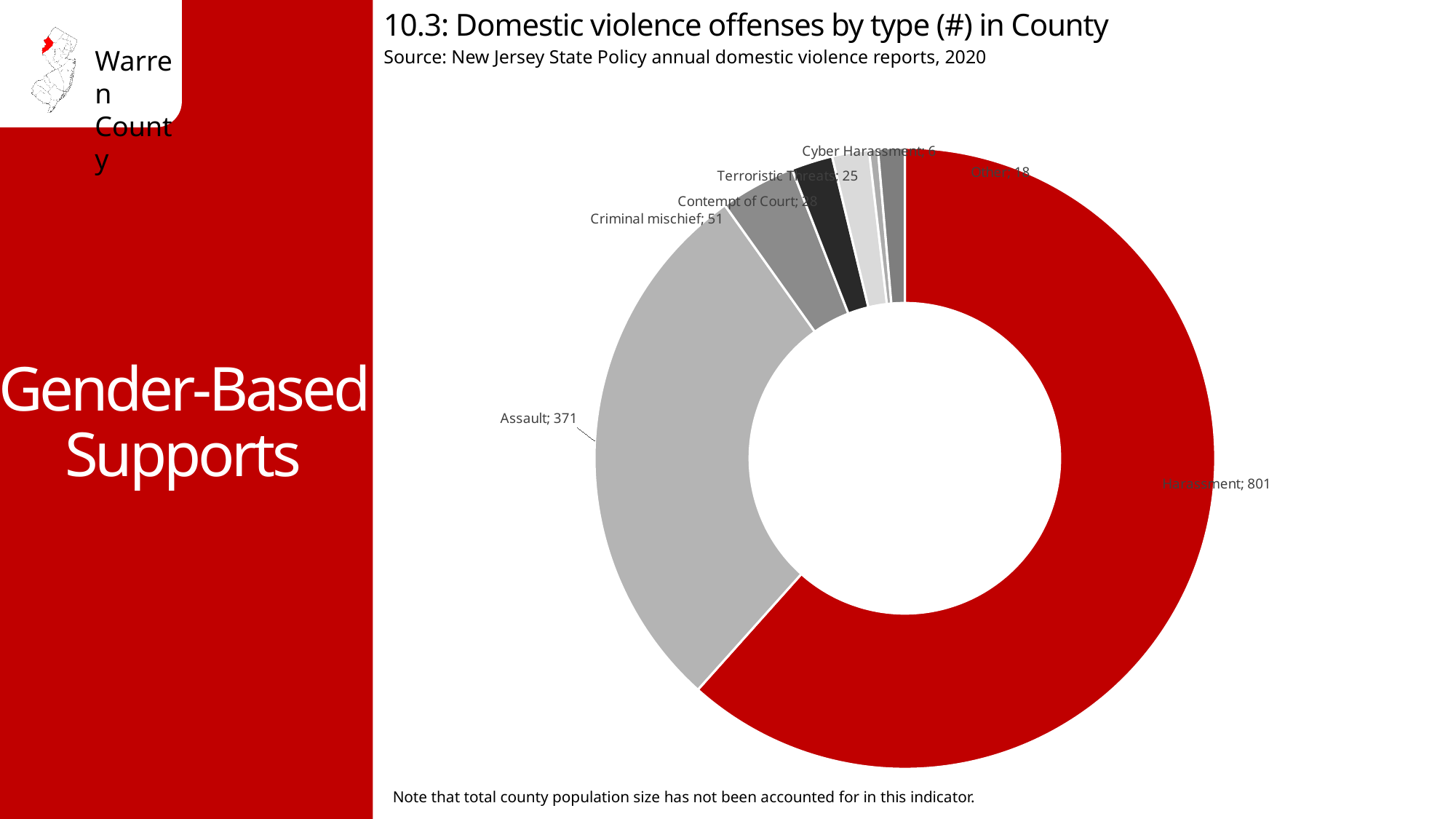
What is the value for Terroristic Threats in the chart? 25 What is the value for Criminal mischief in the chart? 51 What is the number of Harassment offenses shown in the chart? 801 What is the value for Cyber Harassment in the chart? 6 Which offense type has the lowest number in the chart? Cyber Harassment What is the difference between the Assault and Criminal mischief values? 320 How many offense types are shown in the chart? 7 Which is larger, the value for Assault or the value for Criminal mischief? Assault What is the number of Assault offenses shown in the chart? 371 What kind of chart is shown on the slide? Doughnut (pie) chart What is the difference between the Harassment and Assault values? 430 Which offense type has the highest number in the chart? Harassment